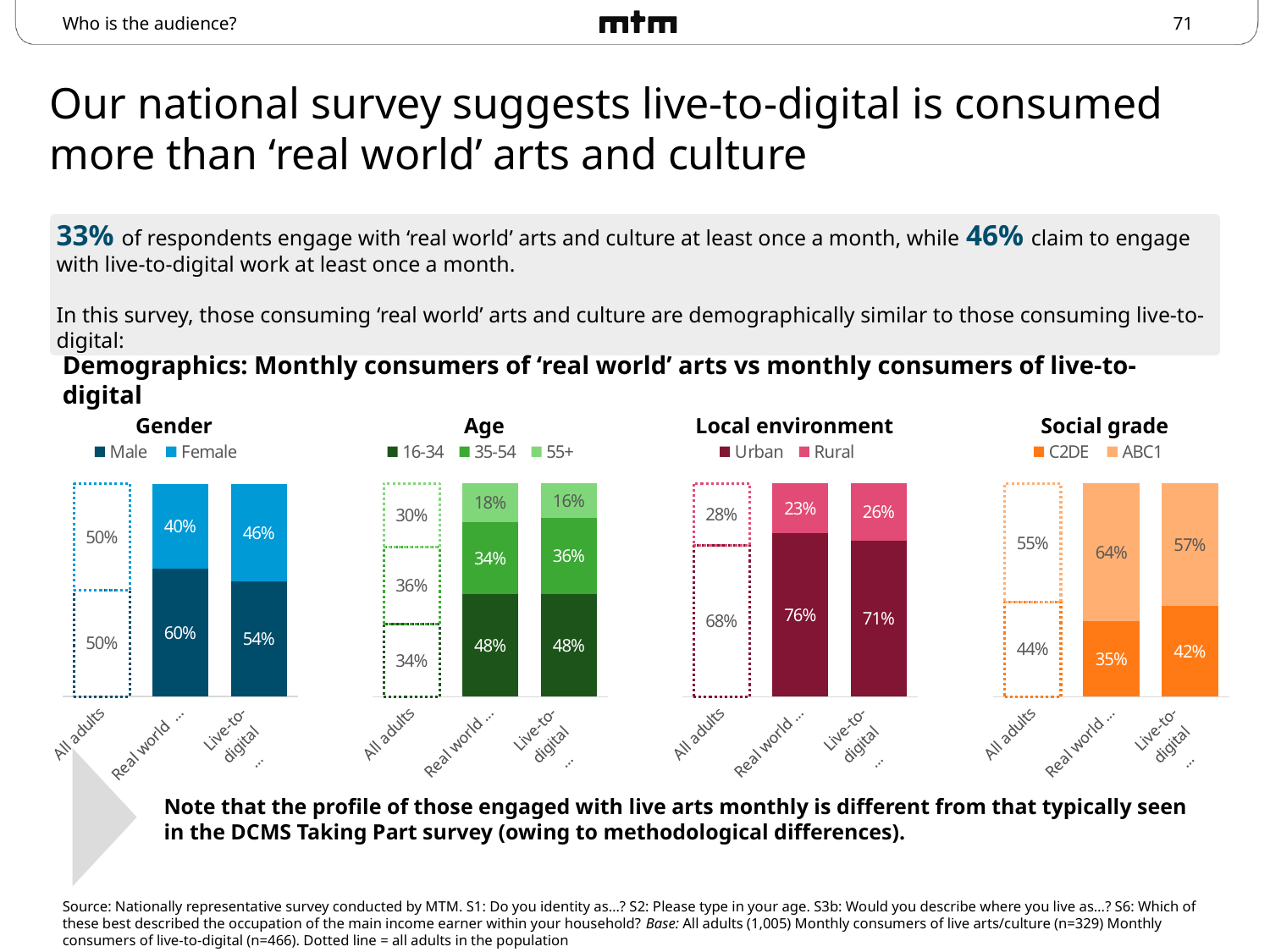
How many series does the legend of the Age chart list? 3 What kind of chart is the Local environment chart? Stacked bar chart In the Age chart, which category has the lowest share of 55+? Live-to-digital In the Local environment chart, what percentage of monthly 'real world' consumers are Urban? 76% How many categories are shown on the x axis of the Social grade chart? 3 In the Social grade chart, what percentage of All adults are ABC1? 55% In the Age chart, what percentage of monthly live-to-digital consumers are aged 55+? 16% How many series does the legend of the Gender chart list? 2 In the Gender chart, what percentage of All adults are Female? 50% In the Social grade chart, which has the larger C2DE share: 'real world' consumers or live-to-digital consumers? Live-to-digital In the Local environment chart, what is the difference in the Urban share between 'real world' consumers and live-to-digital consumers? 5 percentage points In the Gender chart, what percentage of monthly 'real world' consumers are Male? 60%